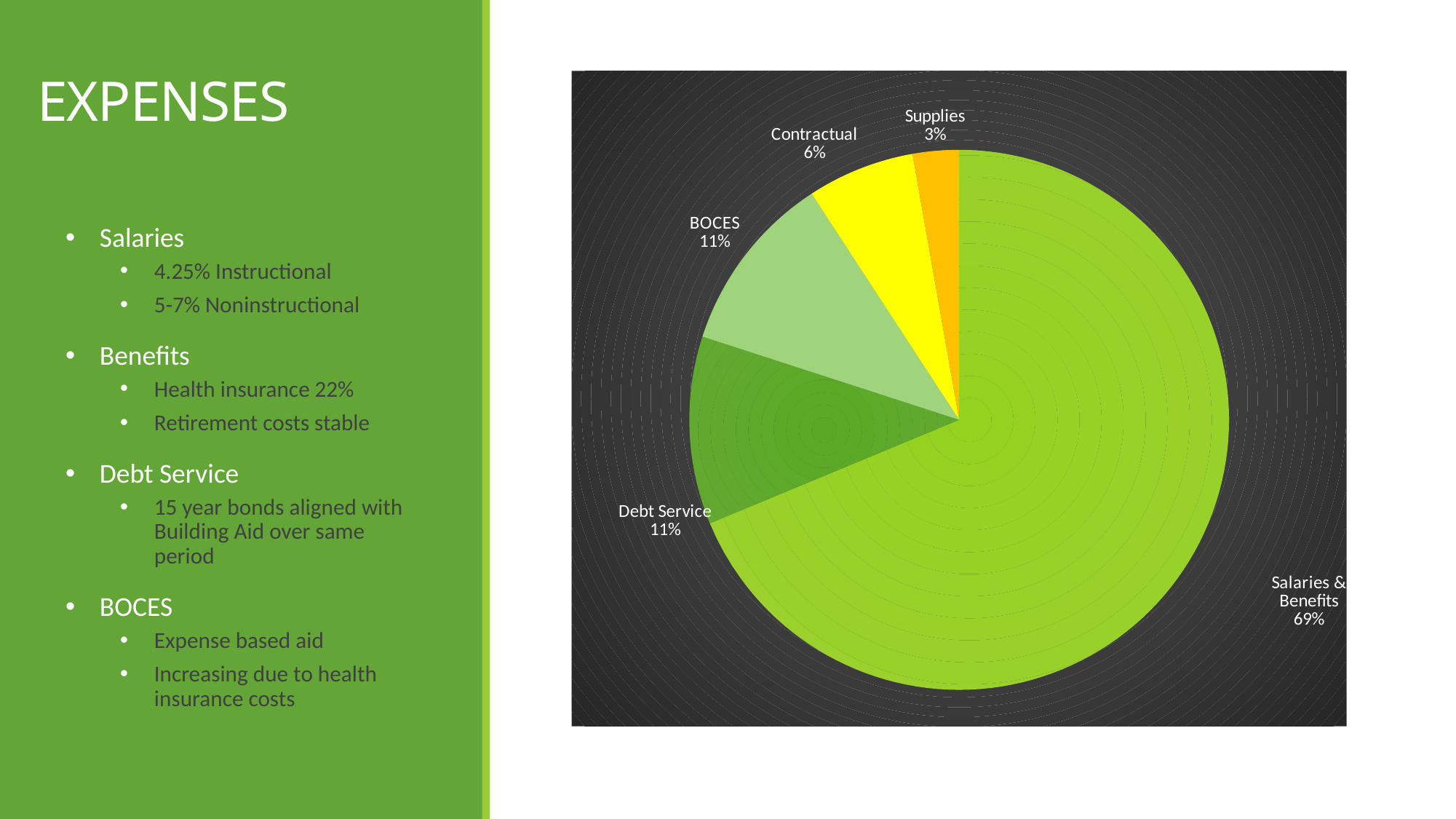
What percentage of the pie is Contractual? 6% Which category has the largest slice of the pie? Salaries & Benefits What percentage of the pie is Debt Service? 11% What percentage of the pie is BOCES? 11% What kind of chart is shown on the slide? pie chart What percentage of the pie is Supplies? 3% Which is larger, Contractual or Supplies? Contractual How many slices does the pie chart have? 5 What share of expenses is Salaries & Benefits? 69% What is the combined percentage of Contractual and Supplies? 9% Which category has the smallest slice of the pie? Supplies What is the difference in percentage points between Salaries & Benefits and Debt Service? 58